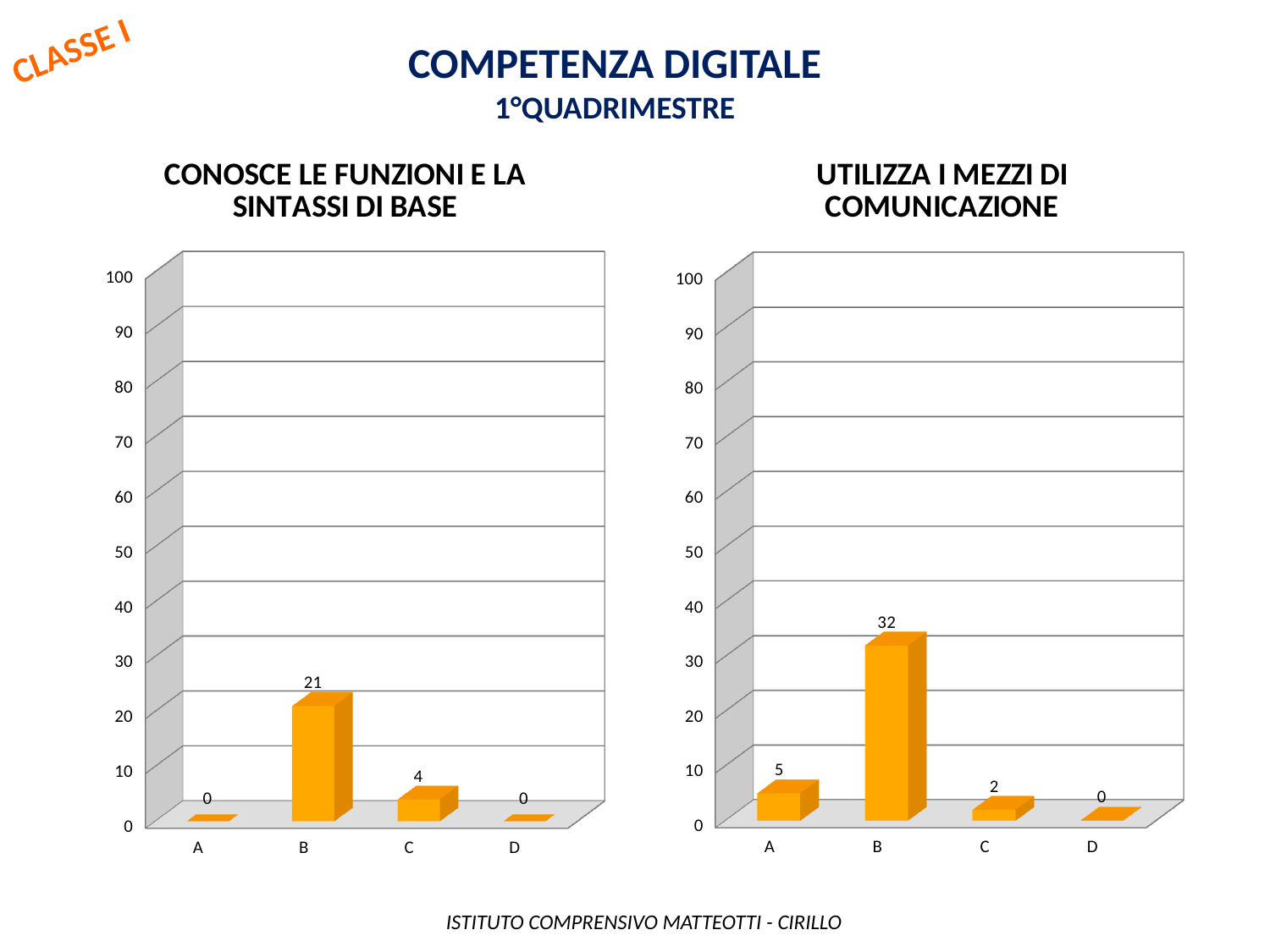
In the 'CONOSCE LE FUNZIONI E LA SINTASSI DI BASE' chart, what is the difference between the values for B and C? 17 What kind of chart is the 'UTILIZZA I MEZZI DI COMUNICAZIONE' chart? Bar chart In the 'CONOSCE LE FUNZIONI E LA SINTASSI DI BASE' chart, which category has the highest value? B In the 'CONOSCE LE FUNZIONI E LA SINTASSI DI BASE' chart, what is the value for B? 21 In the 'UTILIZZA I MEZZI DI COMUNICAZIONE' chart, what is the value for A? 5 In the 'UTILIZZA I MEZZI DI COMUNICAZIONE' chart, which category has the highest value? B In the 'UTILIZZA I MEZZI DI COMUNICAZIONE' chart, what is the difference between the values for B and A? 27 In the 'UTILIZZA I MEZZI DI COMUNICAZIONE' chart, is the value for B greater or less than 30? greater In the 'UTILIZZA I MEZZI DI COMUNICAZIONE' chart, what is the value for B? 32 In the 'UTILIZZA I MEZZI DI COMUNICAZIONE' chart, which is larger, the value for A or the value for C? A How many categories are shown on the x axis of the 'CONOSCE LE FUNZIONI E LA SINTASSI DI BASE' chart? 4 In the 'CONOSCE LE FUNZIONI E LA SINTASSI DI BASE' chart, what is the value for C? 4